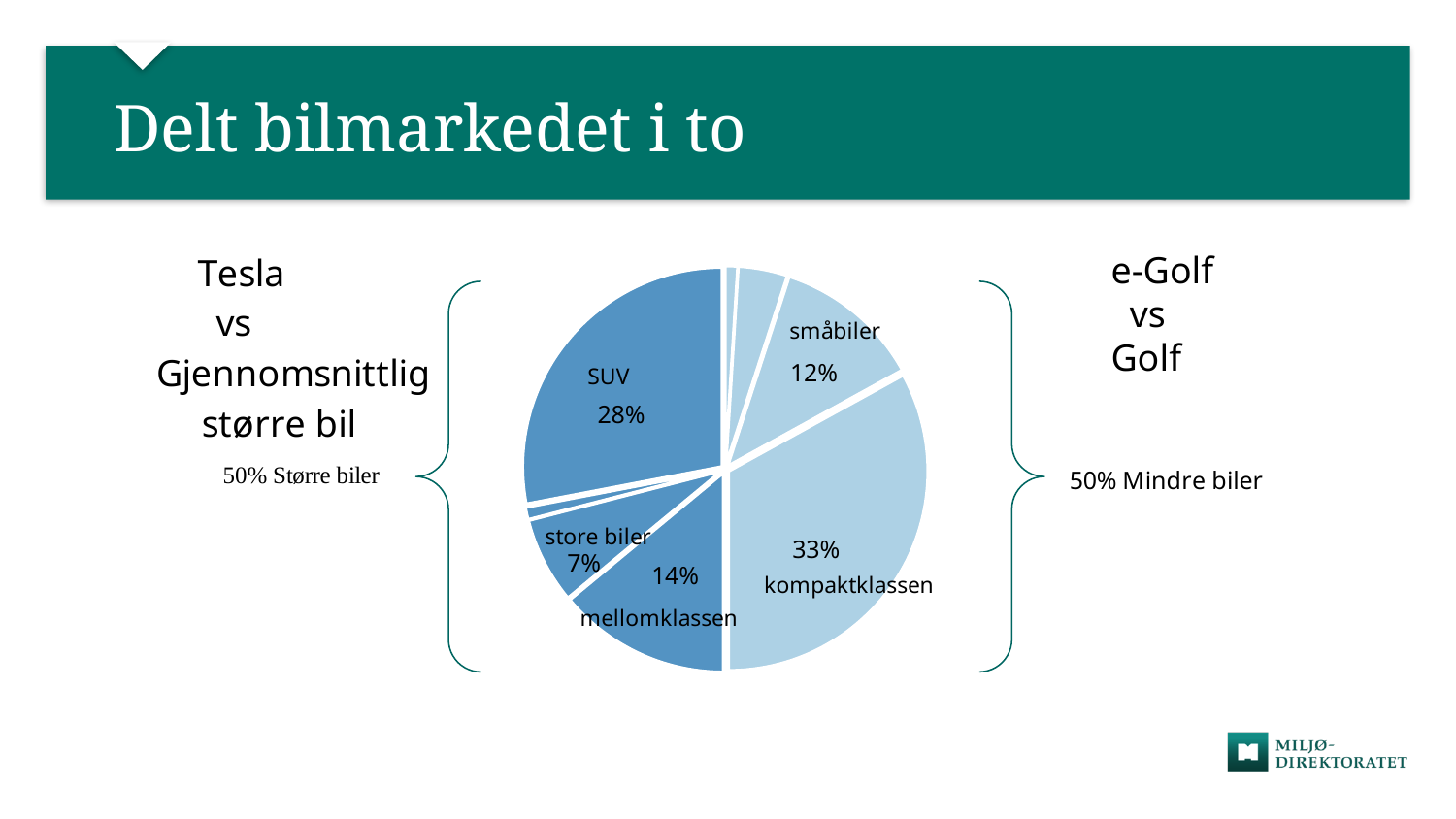
Which is larger, the slice for mellomklassen or the slice for store biler? mellomklassen What is the difference in percentage points between kompaktklassen and SUV? 5 Which is larger, the slice for SUV or the slice for småbiler? SUV What percentage is shown for småbiler? 12% What share of the pie does kompaktklassen have? 33% What is the title of the slide containing the chart? Delt bilmarkedet i to What percentage is shown for SUV? 28% What is the difference in percentage points between SUV and mellomklassen? 14 What percentage is shown for mellomklassen? 14% What kind of chart is shown on the slide? pie chart Which labelled slice of the pie is the largest? kompaktklassen What percentage is shown for store biler? 7%